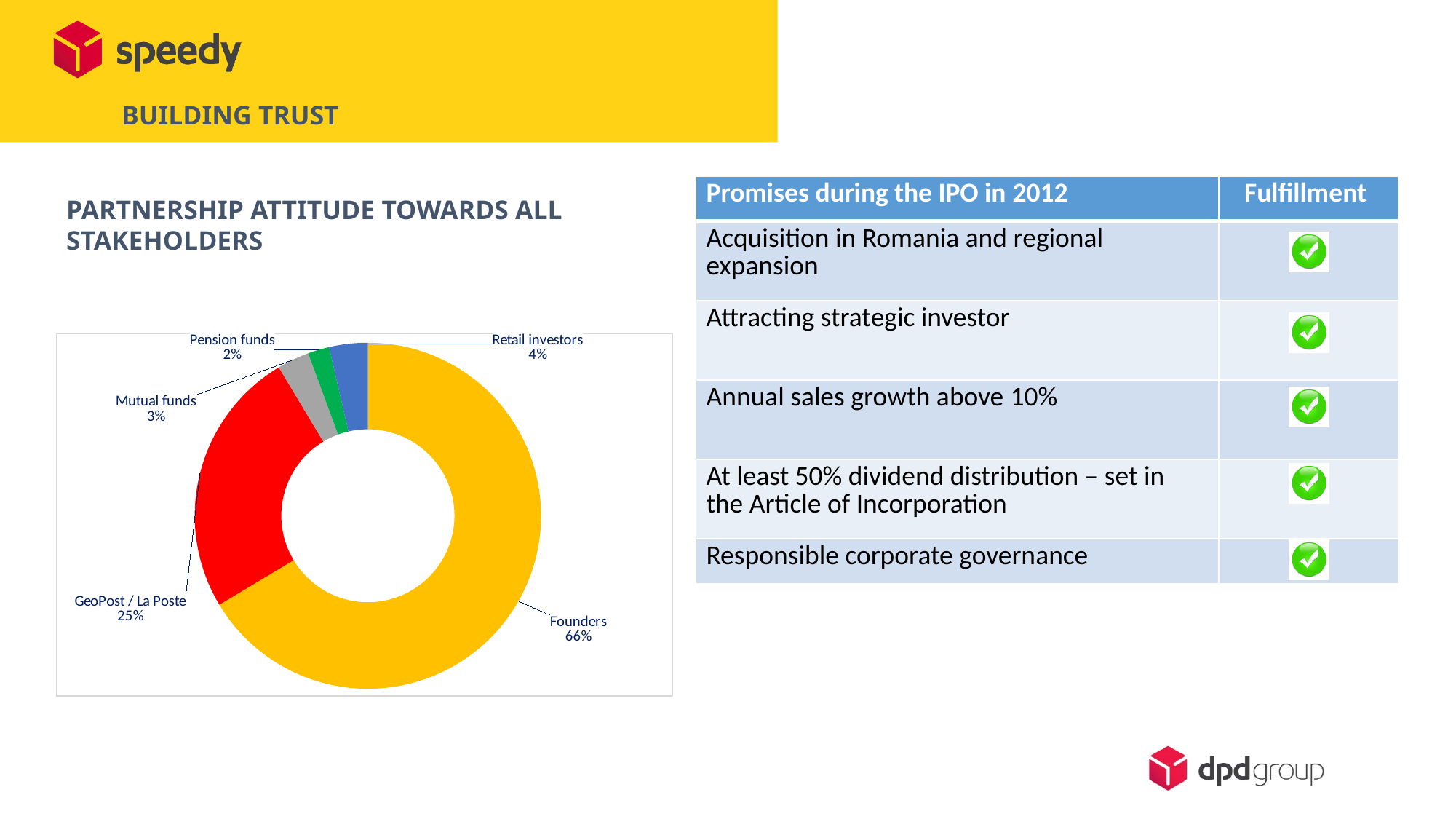
What percentage does GeoPost / La Poste hold in the pie chart? 25% What is the difference in percentage points between Founders and GeoPost / La Poste? 41 Which category has the largest share in the pie chart? Founders What percentage is shown for Pension funds? 2% What percentage is shown for Mutual funds? 3% Which is larger, the share for Retail investors or the share for Mutual funds? Retail investors Which category has the smallest share in the pie chart? Pension funds What is the value shown for Retail investors in the pie chart? 4% What share of the pie chart is held by Founders? 66% How many categories are shown in the pie chart? 5 What colour is the Founders slice in the pie chart? Yellow What type of chart is shown on the slide? Pie chart (doughnut)